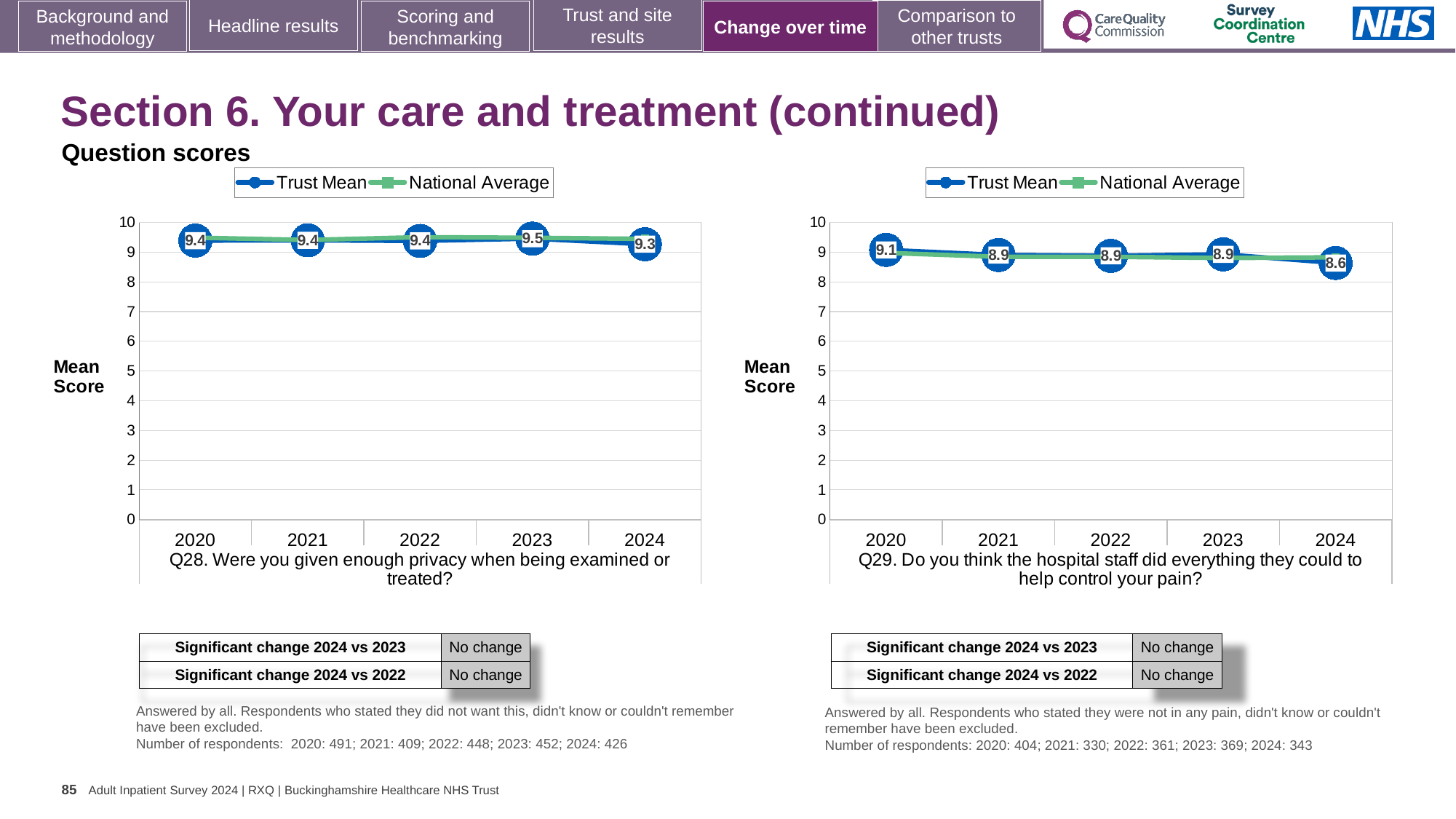
In the Q29 chart (right), which year has the lowest Trust Mean score? 2024 What kind of chart is the Q29 chart (right)? Line chart In the Q29 chart (right), what is the Trust Mean score for 2024? 8.6 In the Q28 chart (left), is the Trust Mean score for 2023 or 2024 higher? 2023 In the Q29 chart (right), what is the Trust Mean score for 2020? 9.1 In the Q28 chart (left), which year has the highest Trust Mean score? 2023 In the Q28 chart (left), what is the Trust Mean score for 2023? 9.5 In the Q29 chart (right), does the Trust Mean score rise or fall from 2020 to 2024? Fall In the Q29 chart (right), what is the difference between the Trust Mean scores for 2020 and 2024? 0.5 How many series does the legend of the Q28 chart (left) list? 2 How many years are plotted on the x axis of the Q29 chart (right)? 5 In the Q28 chart (left), what is the Trust Mean score for 2024? 9.3